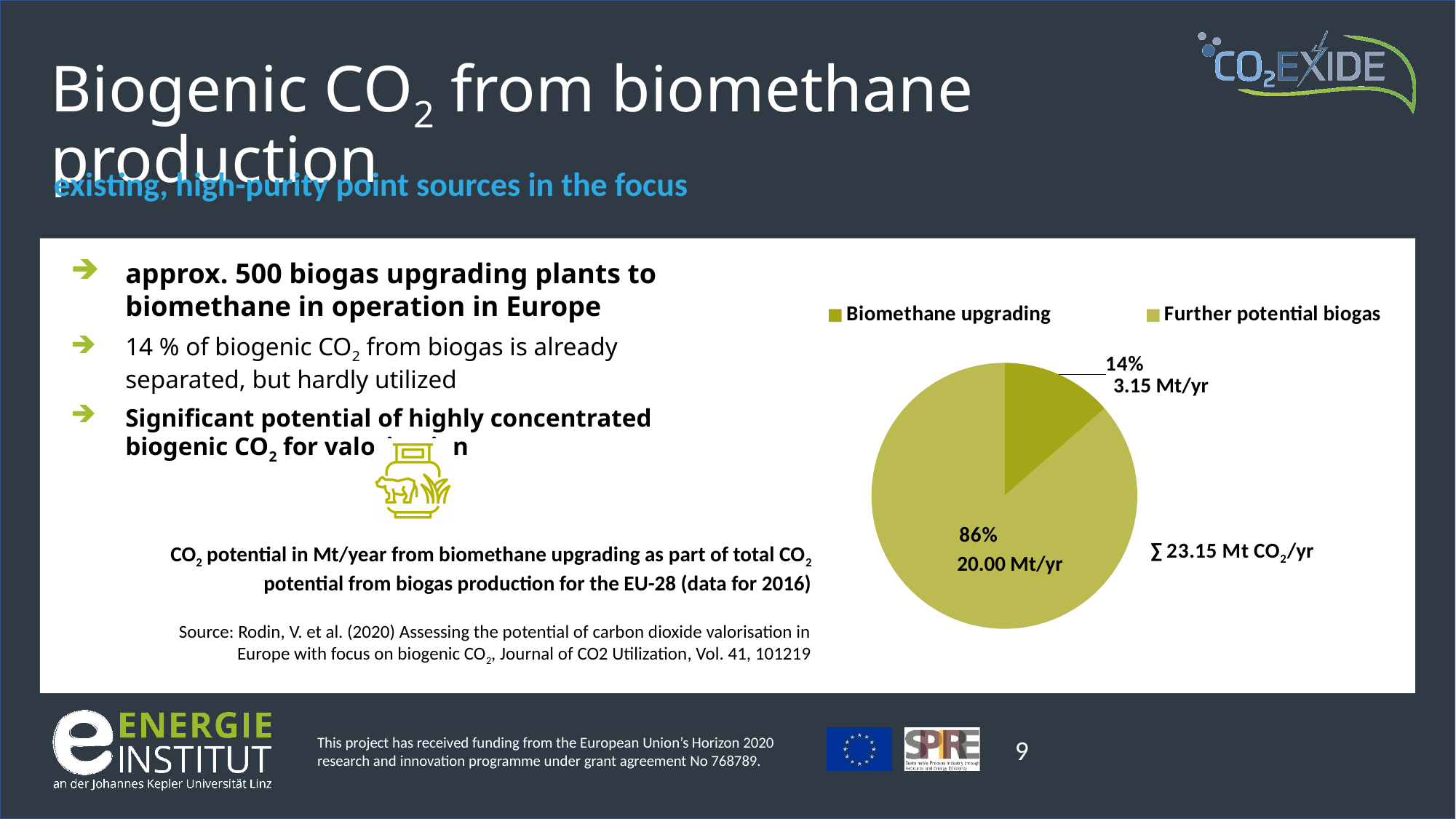
What kind of chart is shown on the slide? pie chart What share of the pie does Biomethane upgrading represent? 14% What is the difference in Mt/yr between Further potential biogas and Biomethane upgrading? 16.85 Mt/yr What total is printed next to the pie chart? ∑ 23.15 Mt CO2/yr What is the value for Further potential biogas in Mt/yr? 20.00 Mt/yr What share of the pie does Further potential biogas represent? 86% What is the value for Biomethane upgrading in Mt/yr? 3.15 Mt/yr Which slice of the pie is the largest? Further potential biogas How many slices does the pie chart have? 2 Which slice of the pie is the smallest? Biomethane upgrading Which is larger, Biomethane upgrading or Further potential biogas? Further potential biogas How many entries does the legend list? 2